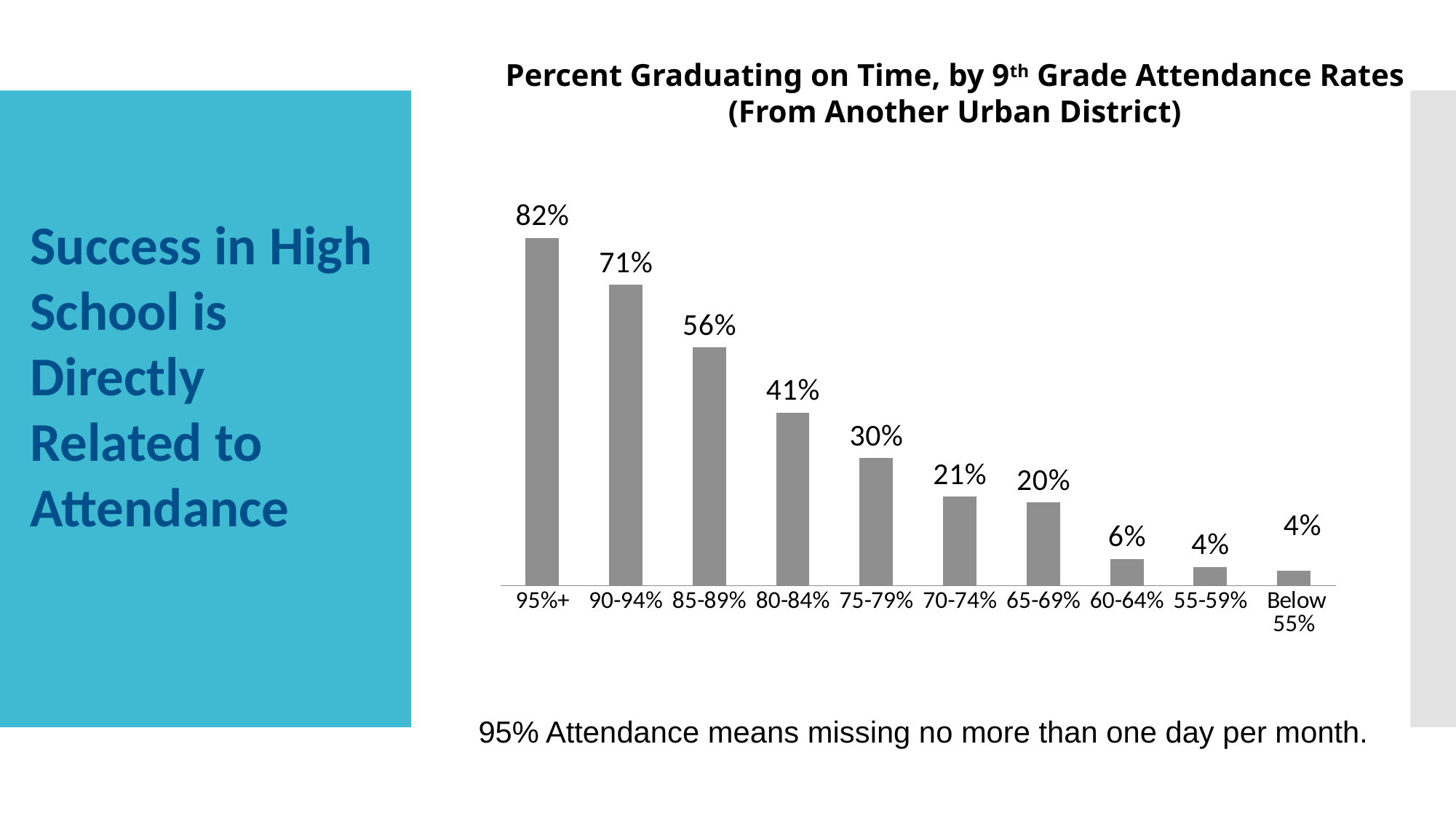
What is the difference between the values for 85-89% and 75-79% attendance? 26% What is the difference in on-time graduation rate between the 95%+ and 90-94% attendance groups? 11% What is the on-time graduation rate for the 80-84% attendance group? 41% Which has a higher on-time graduation rate, the 70-74% group or the 65-69% group? 70-74% What percent graduated on time among students with 95%+ attendance? 82% What type of chart is shown on the slide? Bar chart What is the title of the chart? Percent Graduating on Time, by 9th Grade Attendance Rates (From Another Urban District) Which attendance category has the highest percent graduating on time? 95%+ What is the value shown for the 60-64% attendance category? 6% Do the values rise or fall as attendance rates decrease from left to right along the x axis? Fall How many attendance categories are shown on the chart? 10 What is the value shown for the 55-59% attendance category? 4%